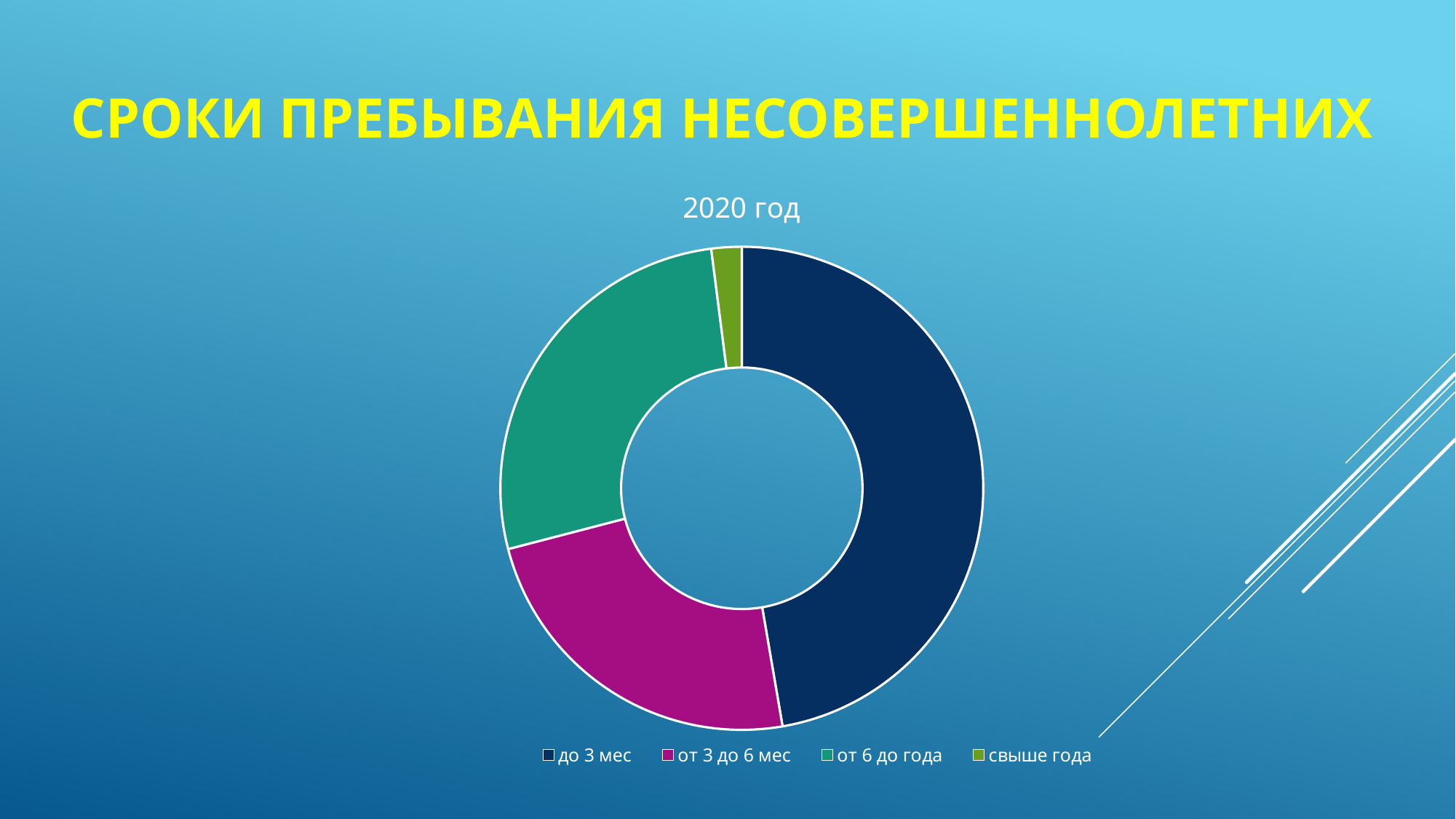
Which category has the smallest share of the chart? свыше года Which is larger: the share for до 3 мес or the share for от 3 до 6 мес? до 3 мес What kind of chart is shown on the slide? Doughnut (pie) chart Which category is listed last in the legend? свыше года What is the title of the chart? 2020 год Which category is shown in dark blue? до 3 мес How many categories does the chart show? 4 Which is larger: the share for от 6 до года or the share for от 3 до 6 мес? от 6 до года Which is larger: the share for от 6 до года or the share for свыше года? от 6 до года Which category has the largest share of the chart? до 3 мес